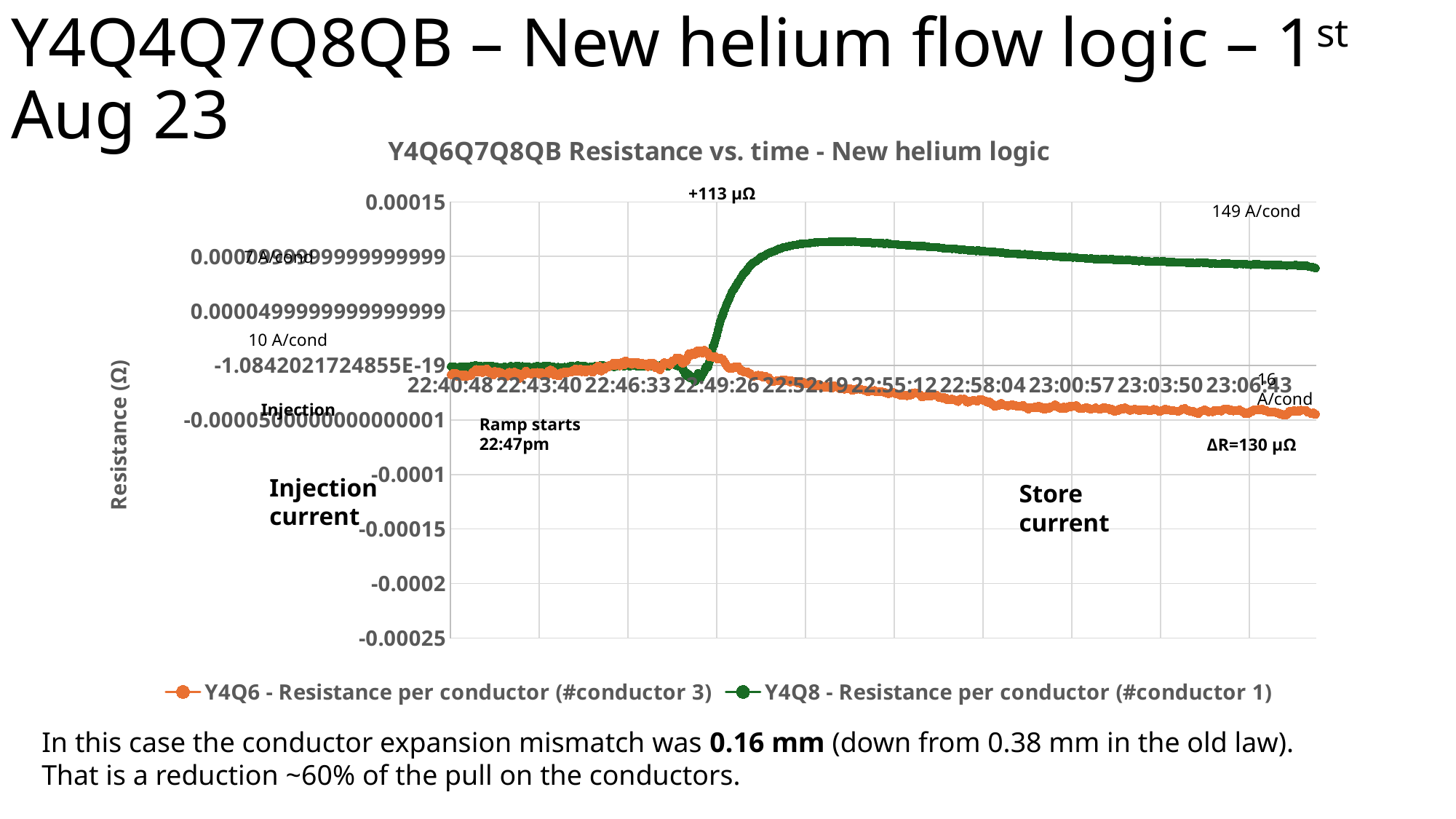
What colour is the line for the Y4Q8 - Resistance per conductor (#conductor 1) series? green Does the Y4Q8 resistance rise or fall between 22:49:26 and 22:52:19? rise How many time labels are shown on the x axis? 10 What ΔR value is annotated on the chart? ΔR=130 μΩ What kind of chart is shown on the slide? line chart Is the Y4Q6 resistance at 23:06:43 greater or less than 0? less Is the Y4Q8 resistance at 23:06:43 greater or less than 0.00005? greater Does the Y4Q6 resistance rise or fall between 22:52:19 and 23:06:43? fall How many series does the chart legend list? 2 What store current per conductor is annotated near the top right of the chart? 149 A/cond What is the title of the chart? Y4Q6Q7Q8QB Resistance vs. time - New helium logic At the right end of the chart (23:06:43), which series has the higher resistance, Y4Q6 or Y4Q8? Y4Q8